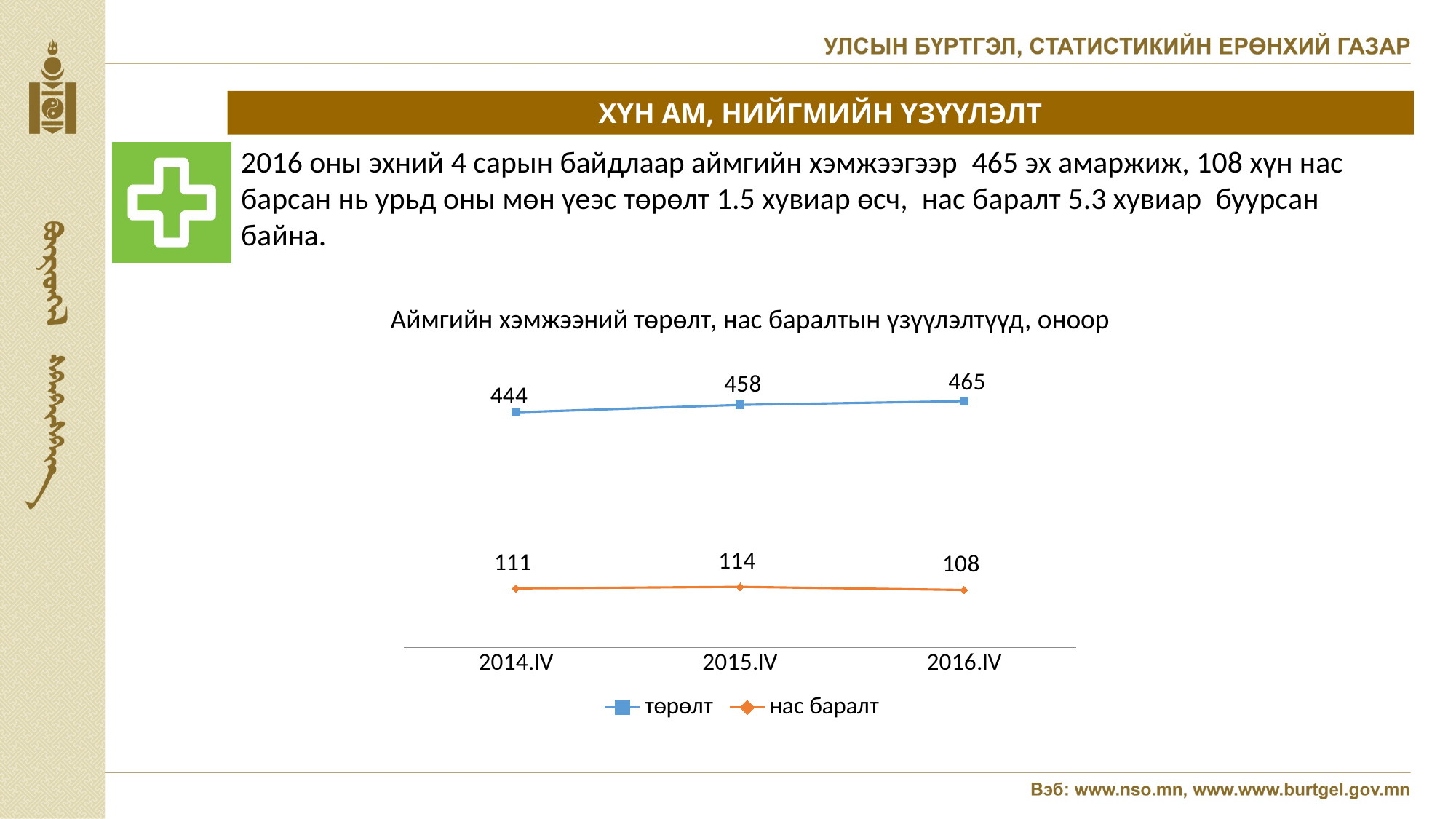
How many periods are shown on the x axis? 3 In which period is нас баралт lowest? 2016.IV What is the difference between төрөлт in 2016.IV and 2014.IV? 21 What is the difference between нас баралт in 2015.IV and 2016.IV? 6 What kind of chart is shown? line chart What is the value of төрөлт for 2016.IV? 465 Does төрөлт rise or fall from 2014.IV to 2016.IV? rise What is the value of төрөлт for 2014.IV? 444 What is the value of нас баралт for 2015.IV? 114 How many series does the legend list? 2 Which is larger: нас баралт in 2014.IV or in 2015.IV? 2015.IV In which period is төрөлт highest? 2016.IV